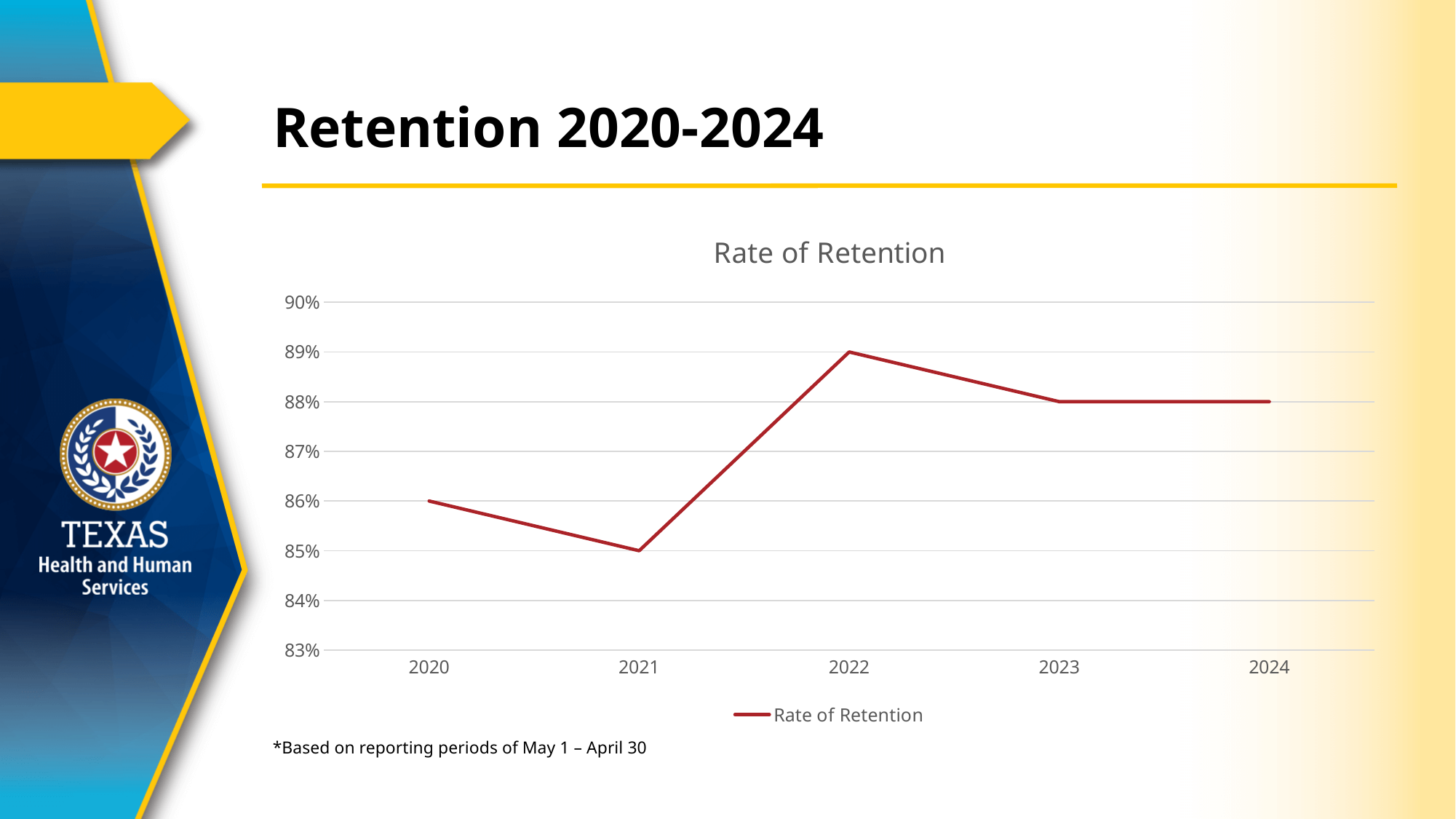
What is the title of the chart? Rate of Retention What type of chart is shown on the slide? line chart What is the rate of retention for 2020? 86% Does the rate of retention rise or fall from 2021 to 2022? rise Which year has a higher rate of retention, 2020 or 2023? 2023 How many series does the legend list? 1 What is the rate of retention for 2021? 85% What is the rate of retention for 2022? 89% Which year has the lowest rate of retention? 2021 What is the difference between the rate of retention in 2022 and in 2021? 4% How many years are plotted on the x axis? 5 Which year has the highest rate of retention? 2022